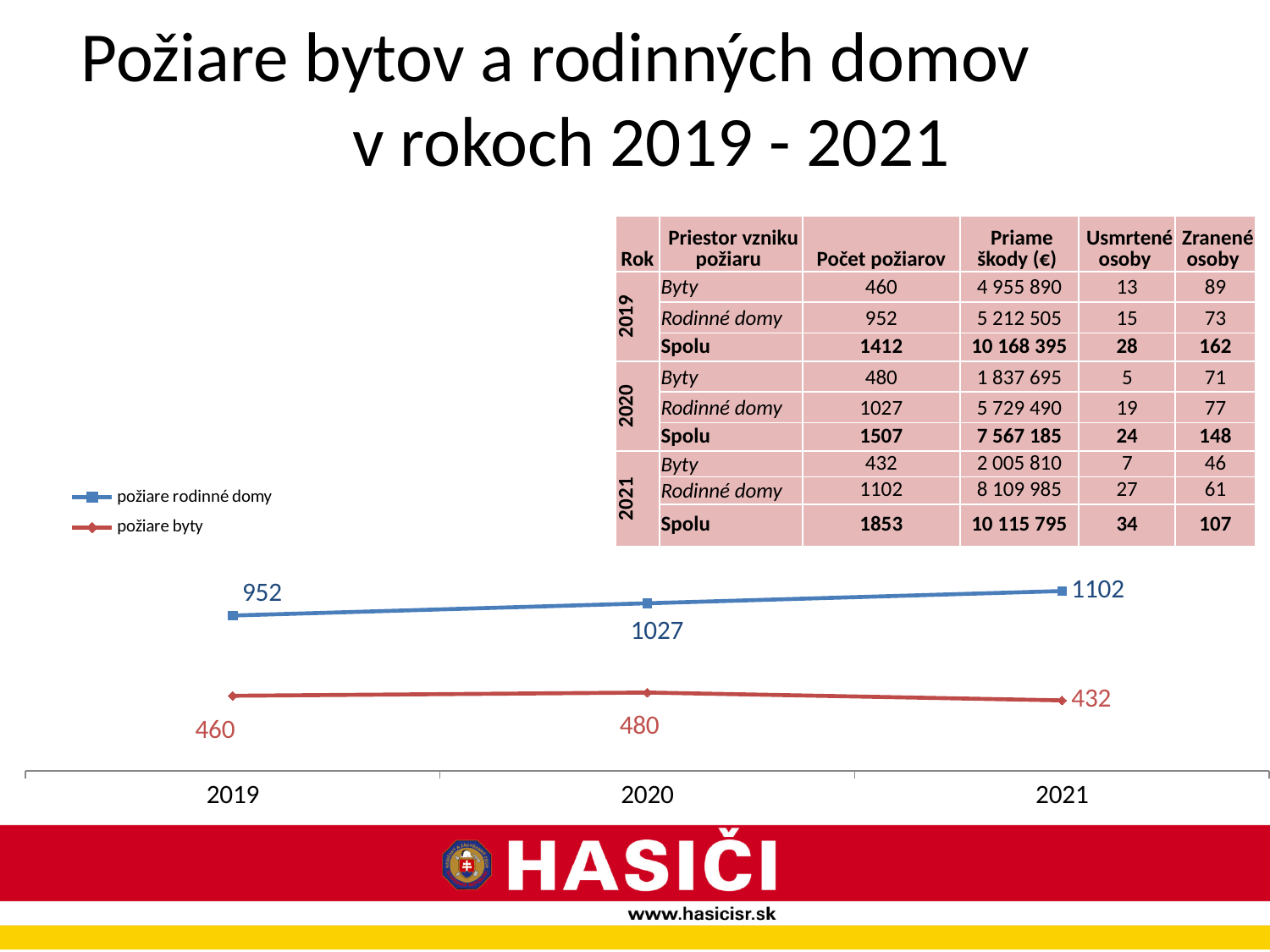
Does požiare rodinné domy rise or fall from 2019 to 2021? rise What is the difference between požiare rodinné domy and požiare byty in 2019? 492 Which is larger in 2020: požiare rodinné domy or požiare byty? požiare rodinné domy How many years are plotted on the x axis? 3 How many series does the legend list? 2 What kind of chart is shown? line chart What is the value for požiare rodinné domy in 2019? 952 What is the difference between požiare rodinné domy in 2021 and in 2020? 75 In which year is požiare byty lowest? 2021 What is the value for požiare rodinné domy in 2021? 1102 What is the value for požiare byty in 2020? 480 In which year is požiare rodinné domy highest? 2021